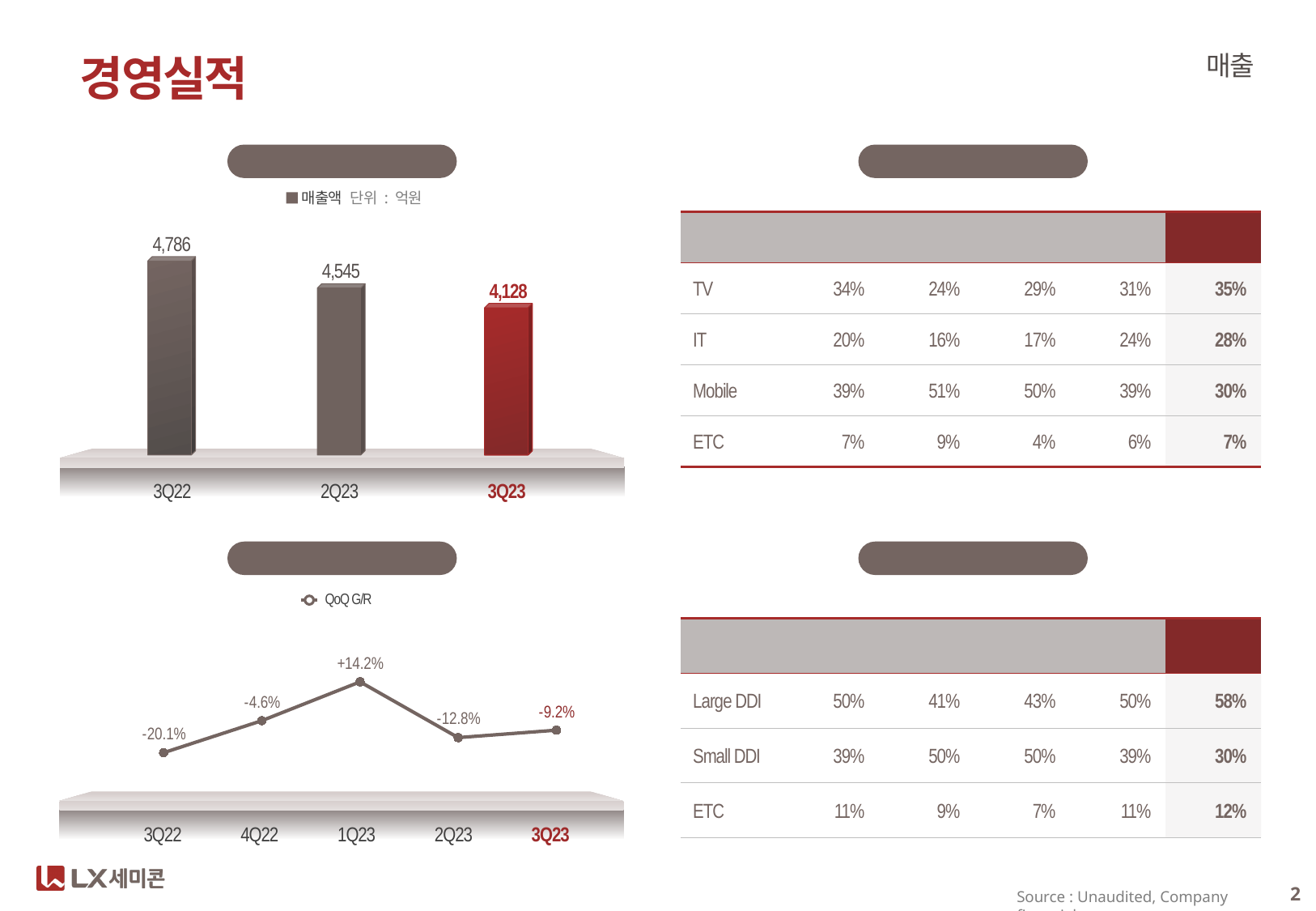
In the top-left bar chart, what is the difference between the values for 2Q23 and 3Q23? 417 In the bottom-left line chart, is the value for 2Q23 or 3Q23 larger? 3Q23 In the bottom-left line chart, what is the QoQ G/R value for 1Q23? +14.2% What kind of chart is the bottom-left chart? line chart In the top-left bar chart, do the values rise or fall from 3Q22 to 3Q23? fall In the top-left bar chart, how many quarters are shown? 3 In the bottom-left line chart, which quarter has the lowest QoQ G/R value? 3Q22 In the top-left bar chart, which quarter has the highest value? 3Q22 In the top-left bar chart, what is the value for 3Q23? 4,128 In the bottom-left line chart, how many data points are plotted? 5 In the top-left bar chart, which quarter has the lowest value? 3Q23 In the top-left bar chart, what is the value for 3Q22? 4,786